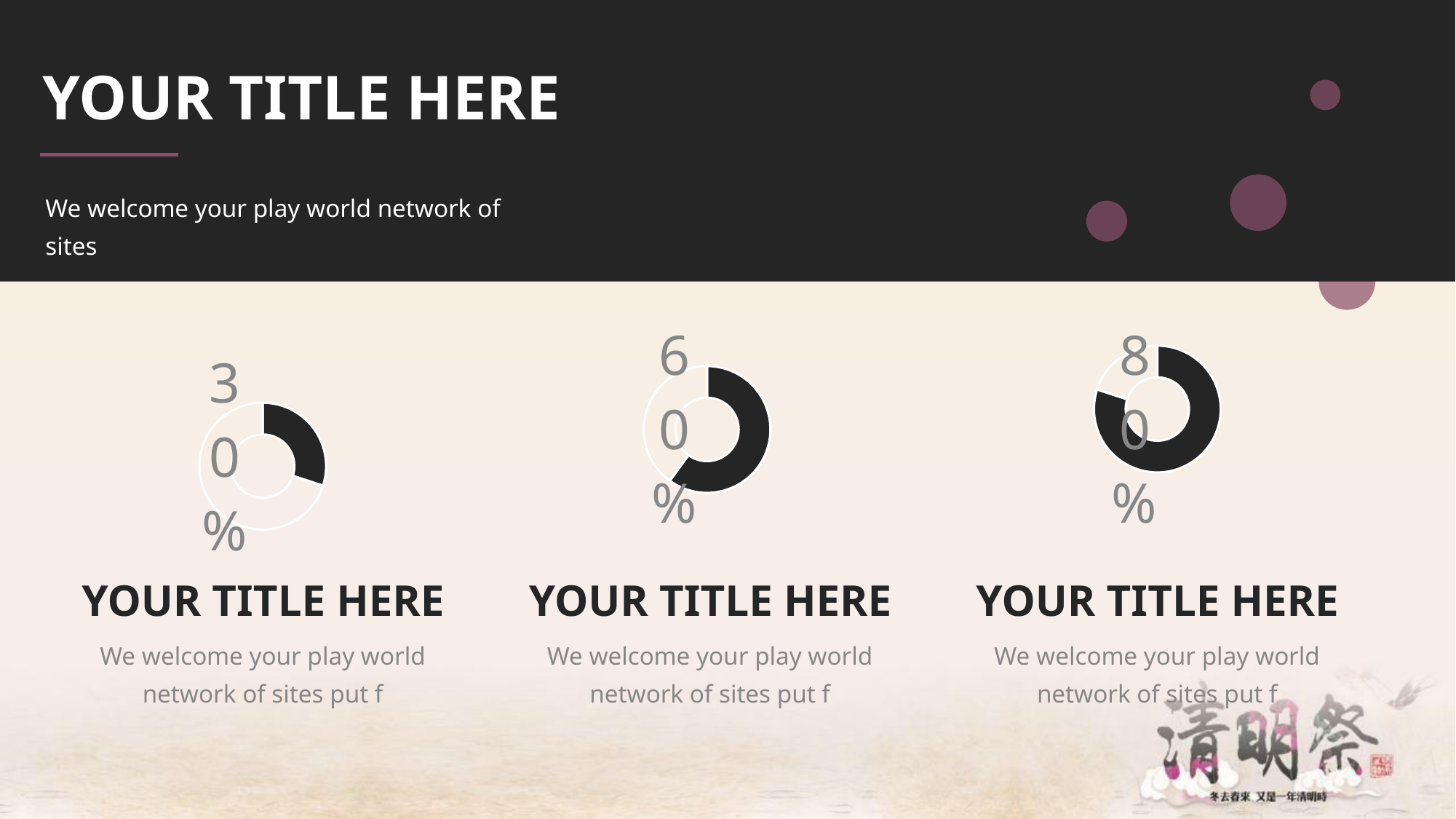
Which of the three doughnut charts shows the highest percentage? The right chart (80%) How many doughnut charts are on the slide? 3 What is the difference between the percentage on the right doughnut chart and the percentage on the left doughnut chart? 50% Which shows a larger percentage, the left doughnut chart or the middle doughnut chart? The middle chart What kind of chart is used for each of the three figures on the slide? Doughnut chart Which of the three doughnut charts shows the lowest percentage? The left chart (30%) What percentage is shown on the left doughnut chart? 30% Do the percentages on the doughnut charts increase or decrease from left to right across the slide? Increase What colour is the filled portion of each doughnut chart? Black What percentage is shown on the middle doughnut chart? 60% What percentage is shown on the right doughnut chart? 80% What is the difference between the percentage on the right doughnut chart and the percentage on the middle doughnut chart? 20%